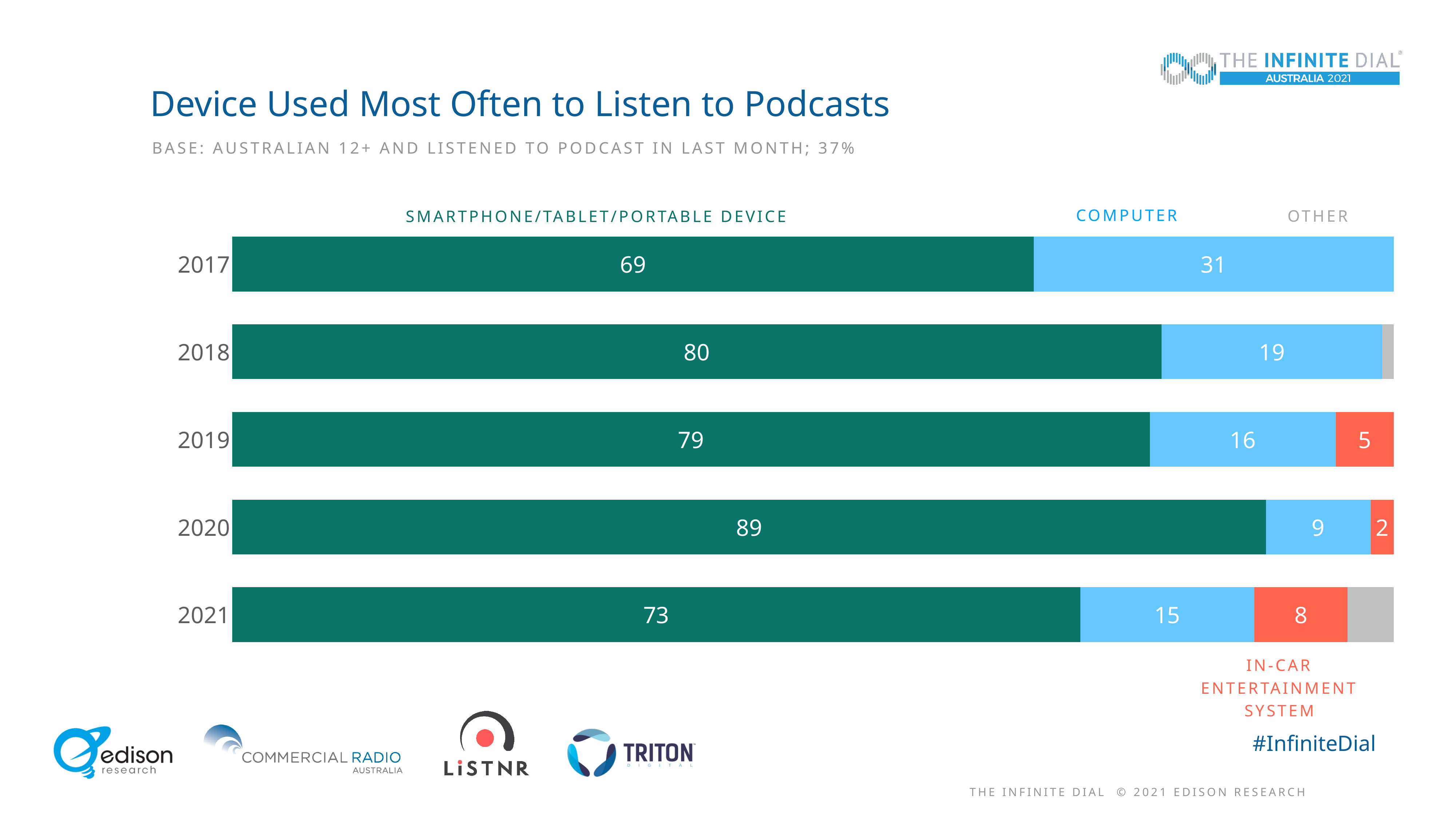
In which year is the Smartphone/Tablet/Portable Device value highest? 2020 What is the value for Smartphone/Tablet/Portable Device in 2020? 89 What is the difference between the Smartphone/Tablet/Portable Device values for 2020 and 2021? 16 In which year is the Computer value lowest? 2020 What is the value for In-Car Entertainment System in 2021? 8 Which is larger, the Computer value in 2018 or in 2021? 2018 What is the title of the chart? Device Used Most Often to Listen to Podcasts How many series does the chart's legend list? 4 What kind of chart is shown on the slide? Stacked bar chart What is the value for Computer in 2017? 31 How many years are shown on the chart? 5 What is the value for Computer in 2019? 16